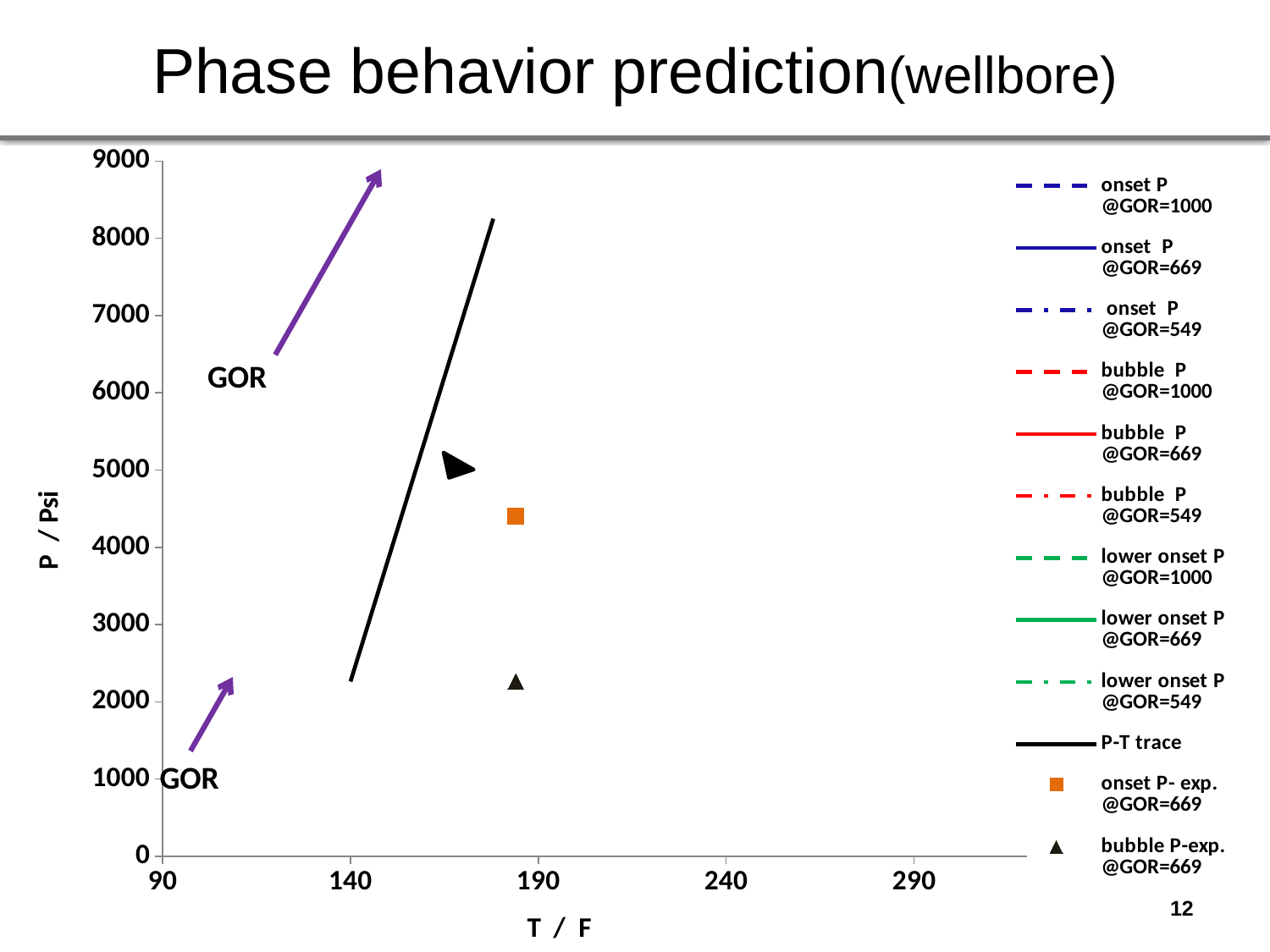
What is the label of the x axis? T / F What kind of chart is shown on the slide? line chart Is the value of the 'onset P- exp. @GOR=669' point greater or less than 5000 psi? less Is the value of the 'onset P- exp. @GOR=669' point greater or less than 4000 psi? greater What is the label of the y axis? P / Psi Is the value of the 'bubble P-exp. @GOR=669' point greater or less than 3000 psi? less How many series does the legend list? 12 Does the 'P-T trace' line rise or fall as temperature increases? rise Which experimental point has the higher pressure, 'onset P- exp. @GOR=669' or 'bubble P-exp. @GOR=669'? onset P- exp. @GOR=669